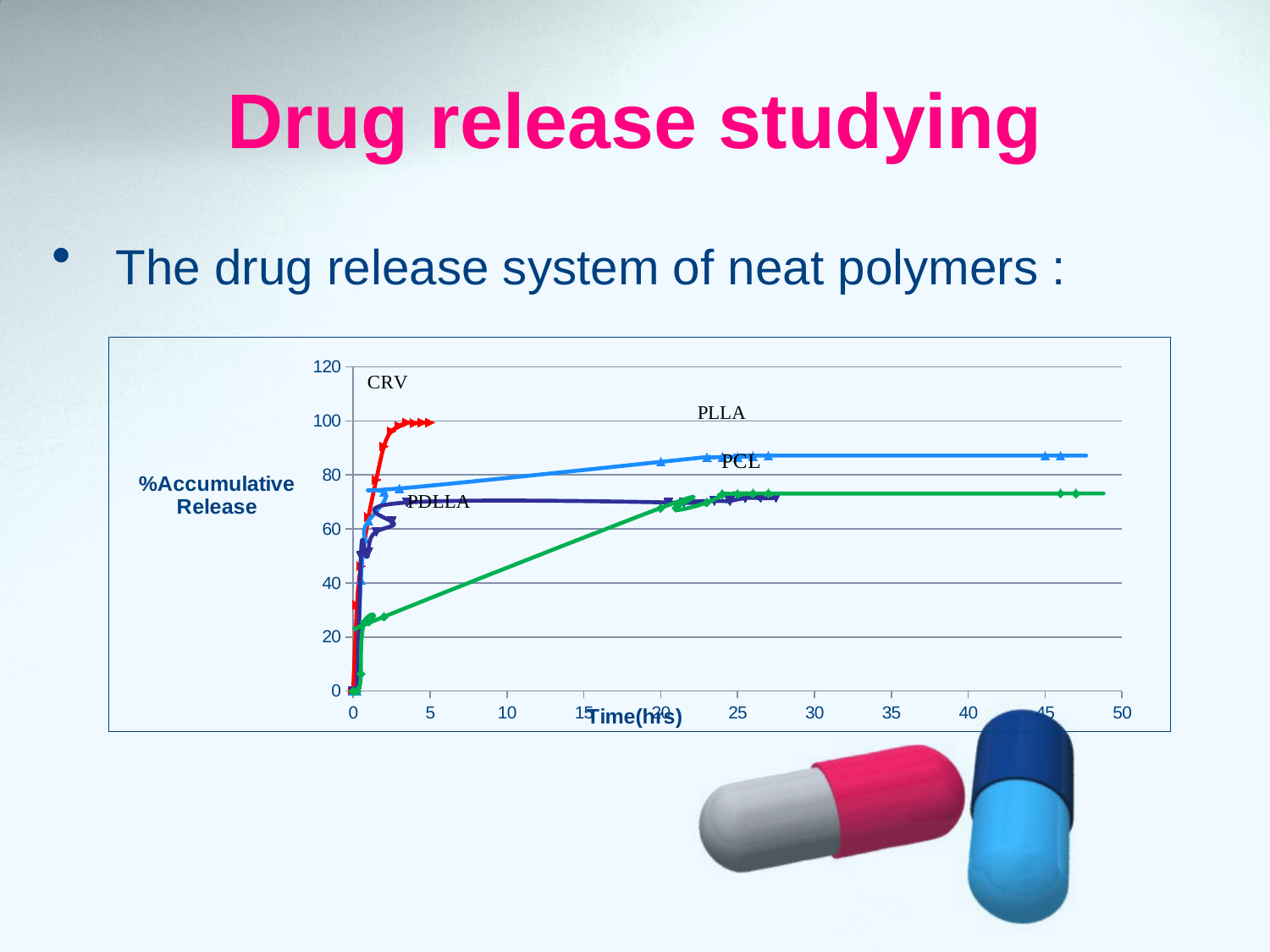
Is the plateau value for PCL greater or less than 80? less Is the plateau value for CRV greater or less than 80? greater Is the plateau value for PDLLA greater or less than 80? less Which series has the higher final %Accumulative Release, PLLA or PDLLA? PLLA How many polymer series are plotted on the chart? 4 Does the %Accumulative Release for PCL rise or fall as time increases? rise Which series reaches the highest %Accumulative Release? CRV What kind of chart is shown on the slide? line chart Which series has the higher final %Accumulative Release, CRV or PCL? CRV What is the label of the y axis of the chart? %Accumulative Release What is the label of the x axis of the chart? Time(hrs)